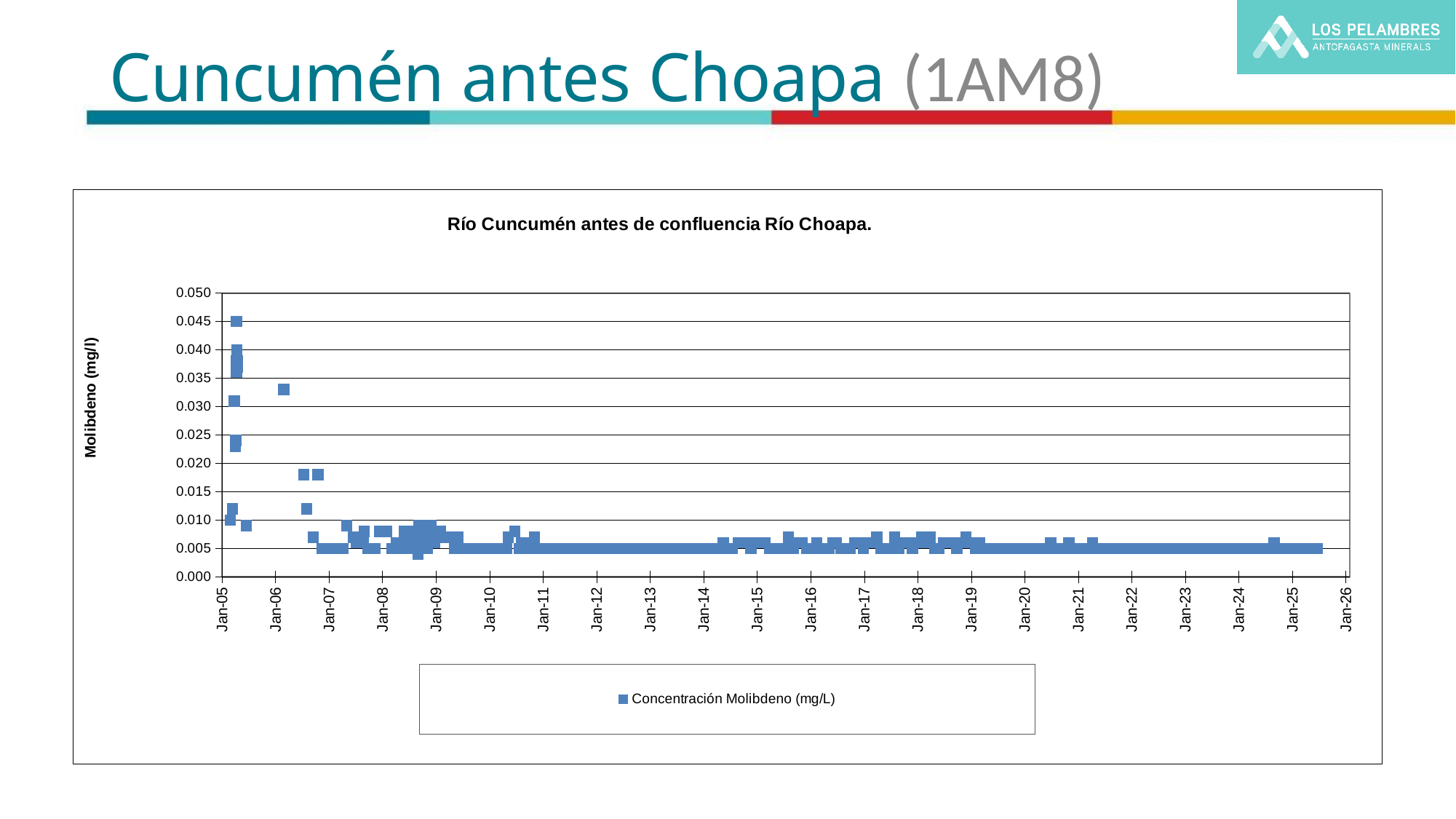
Are the two molybdenum values plotted just before Jan-07 greater or less than 0.020? less What is the maximum value shown on the y axis? 0.050 What kind of chart is shown on the slide? scatter chart What is the title of the chart? Río Cuncumén antes de confluencia Río Choapa. Is the highest molybdenum value plotted (near Jan-05) greater or less than 0.040? greater Are the molybdenum values plotted after Jan-10 greater or less than 0.010? less What is the name of the series shown in the legend? Concentración Molibdeno (mg/L) How many series does the chart legend list? 1 Do the molybdenum concentration values generally rise or fall over time along the x axis? fall